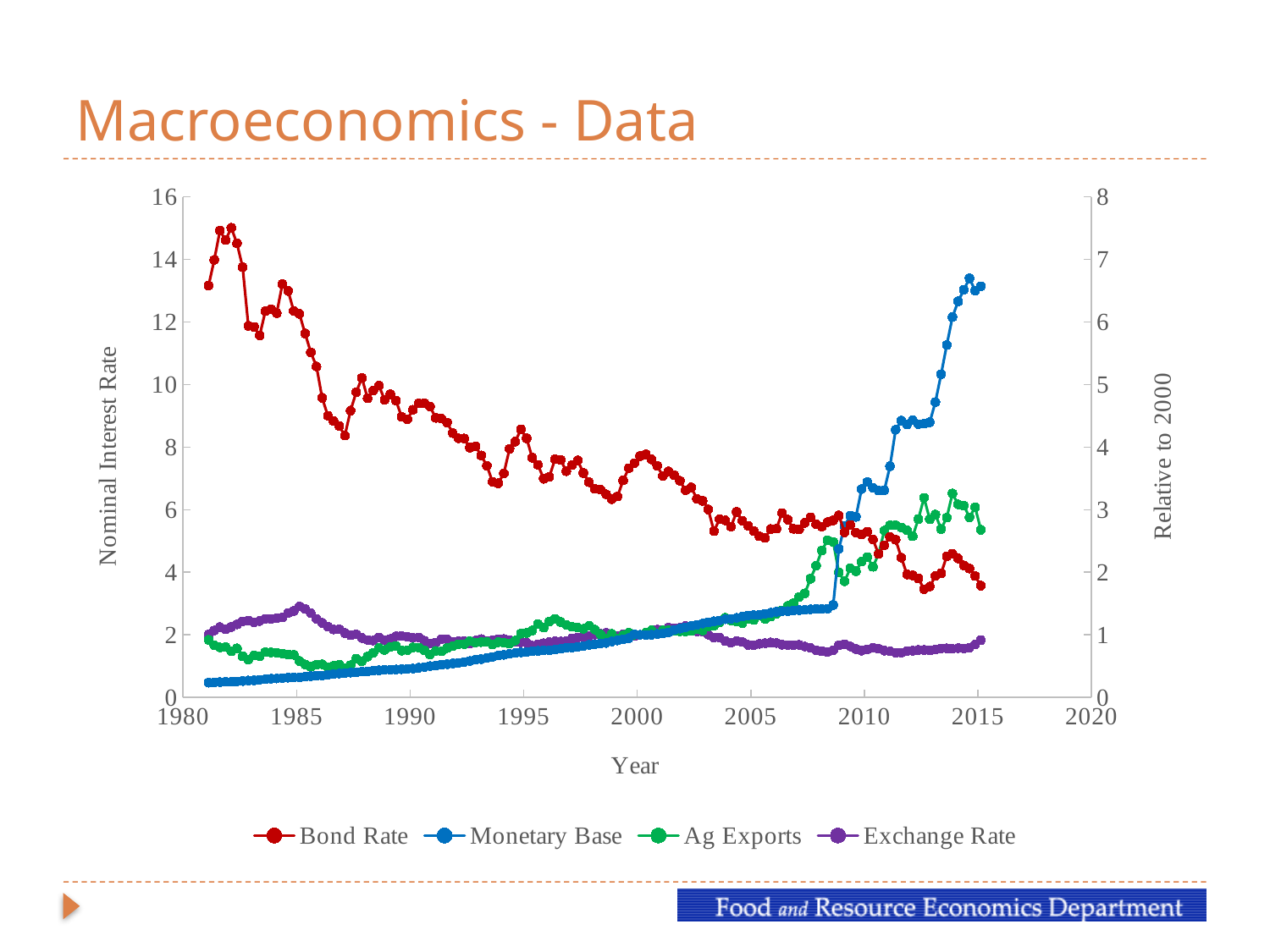
In 2015, which series is higher on the right axis, Monetary Base or Ag Exports? Monetary Base What is the label of the left vertical axis? Nominal Interest Rate Which of the series plotted on the right axis reaches the highest value? Monetary Base Is the Bond Rate value in 2015 greater or less than 4 on the left axis? less How many series does the legend list? 4 Is the Bond Rate value in 1981 greater or less than 12 on the left axis? greater Does the Bond Rate series rise or fall overall from 1981 to 2015? fall What kind of chart is shown on the slide? line chart Is the Exchange Rate value in 2010 greater or less than 1 on the right axis? less Which series are listed in the legend? Bond Rate, Monetary Base, Ag Exports, Exchange Rate Does the Monetary Base series rise or fall overall from 1981 to 2015? rise